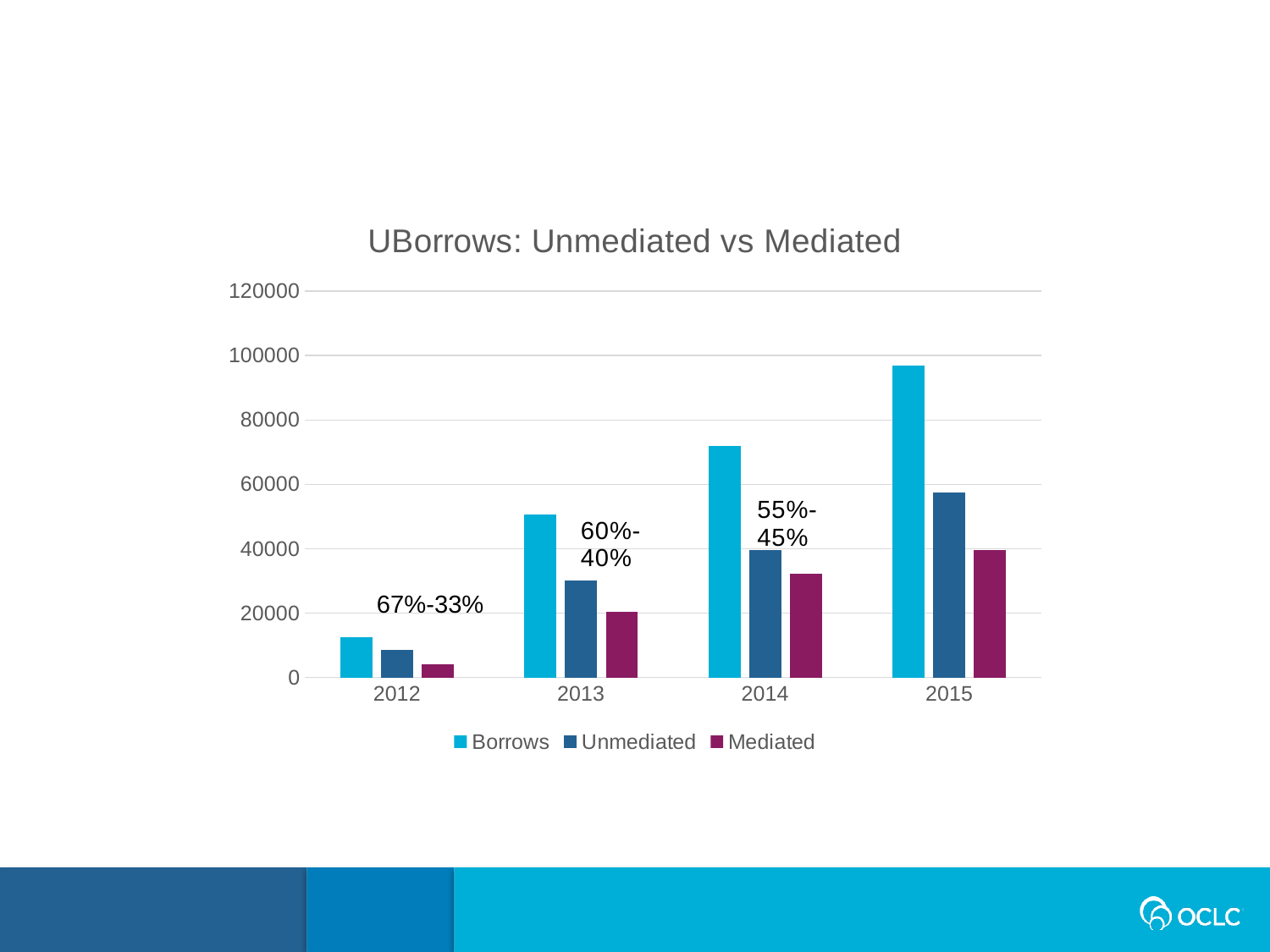
In which year is the Mediated value lowest? 2012 How many series does the legend list? 3 What type of chart is shown on the slide? bar chart Do the Borrows values rise or fall from 2012 to 2015? rise What is the title of the chart? UBorrows: Unmediated vs Mediated In which year is the Borrows value highest? 2015 What percentage split is annotated above the 2012 bars? 67%-33% Is the Unmediated value for 2015 greater or less than 60000? less Is the Borrows value for 2015 greater or less than 80000? greater Is the Borrows value for 2012 greater or less than 20000? less How many years are shown on the x axis? 4 Which is larger: the Borrows value for 2013 or the Unmediated value for 2014? Borrows value for 2013